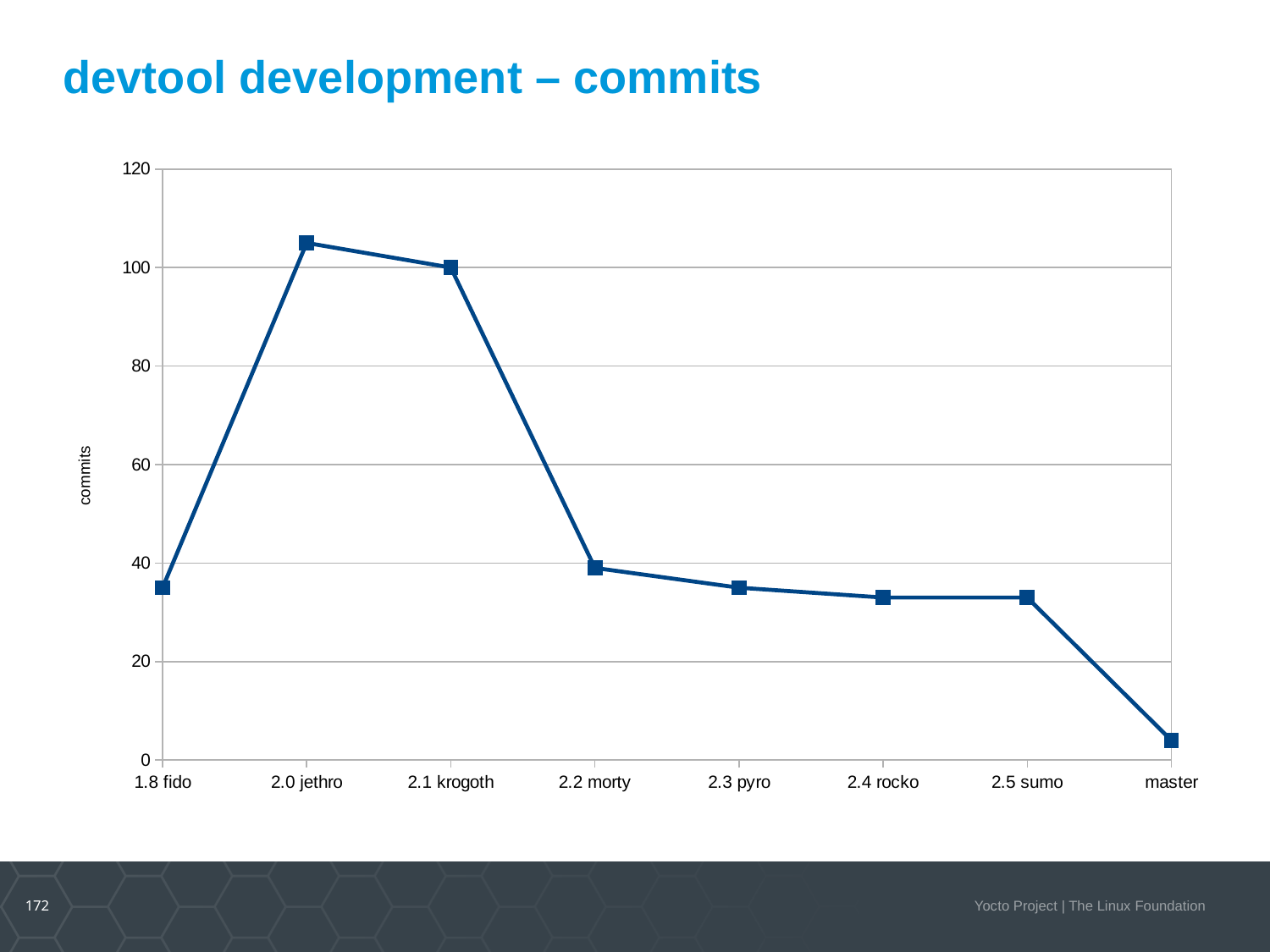
What kind of chart is shown on the slide? line chart Do the commit values rise or fall from 2.1 krogoth to master? fall Which point has the lowest number of commits? master Is the value for 2.4 rocko greater or less than 40? less Is the value for 2.0 jethro greater or less than 100? greater How many release points are plotted along the x axis? 8 Which has more commits, 2.1 krogoth or 2.3 pyro? 2.1 krogoth Is the value for 1.8 fido greater or less than 40? less Which release has the highest number of commits? 2.0 jethro What is the label on the y axis? commits Which has more commits, 2.0 jethro or 2.2 morty? 2.0 jethro